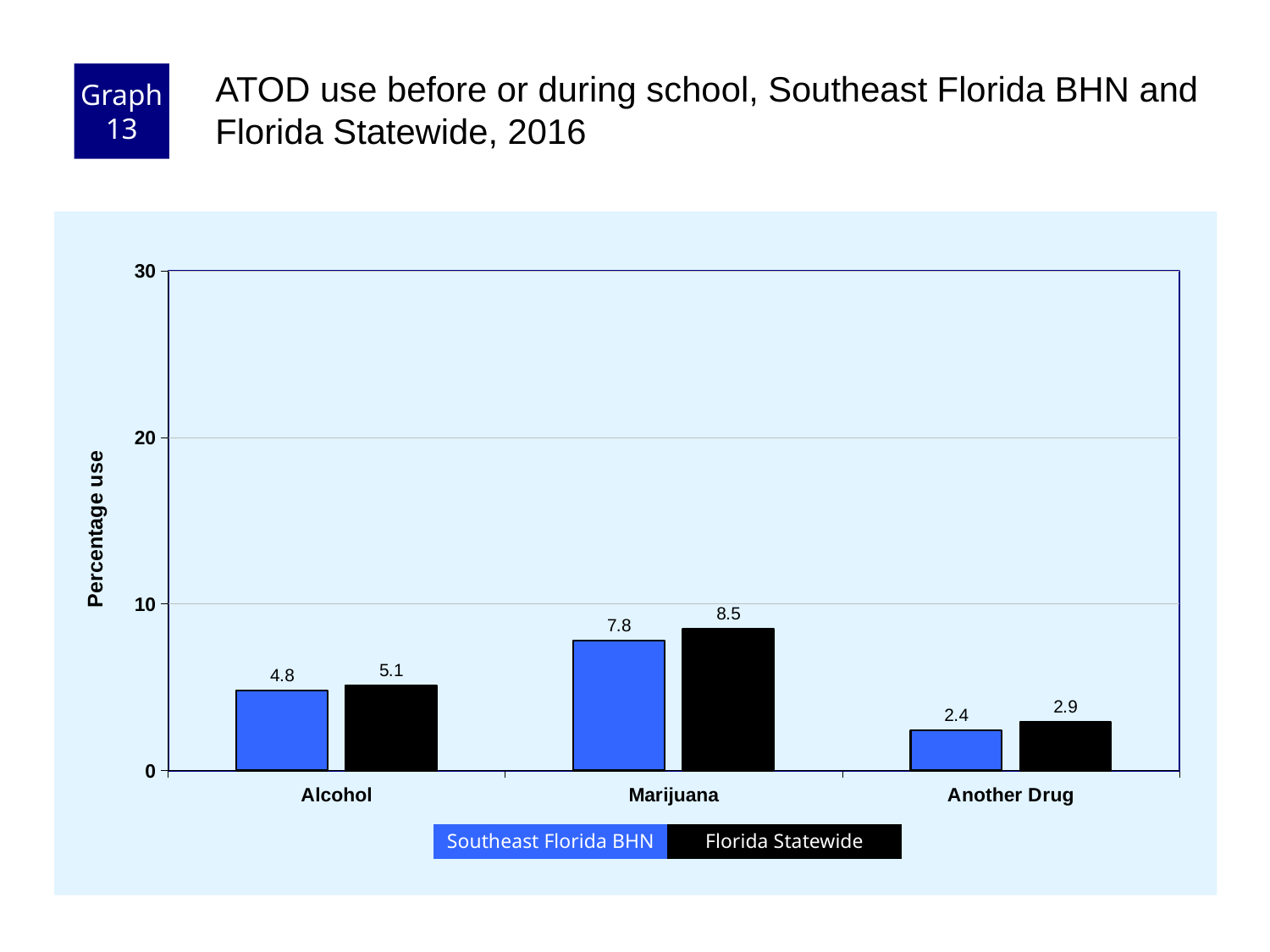
How many categories are shown on the x axis? 3 Which category has the lowest Southeast Florida BHN value? Another Drug How many series does the legend list? 2 Is the Florida Statewide value for Marijuana greater or less than 10? less What is the difference between the Florida Statewide and Southeast Florida BHN values for Marijuana? 0.7 What is the Southeast Florida BHN value for Another Drug? 2.4 What kind of chart is shown on the slide? bar chart Which is larger for Another Drug: Southeast Florida BHN or Florida Statewide? Florida Statewide What is the Florida Statewide value for Alcohol? 5.1 Which category has the highest Florida Statewide value? Marijuana What is the Southeast Florida BHN value for Alcohol? 4.8 What is the Florida Statewide value for Marijuana? 8.5